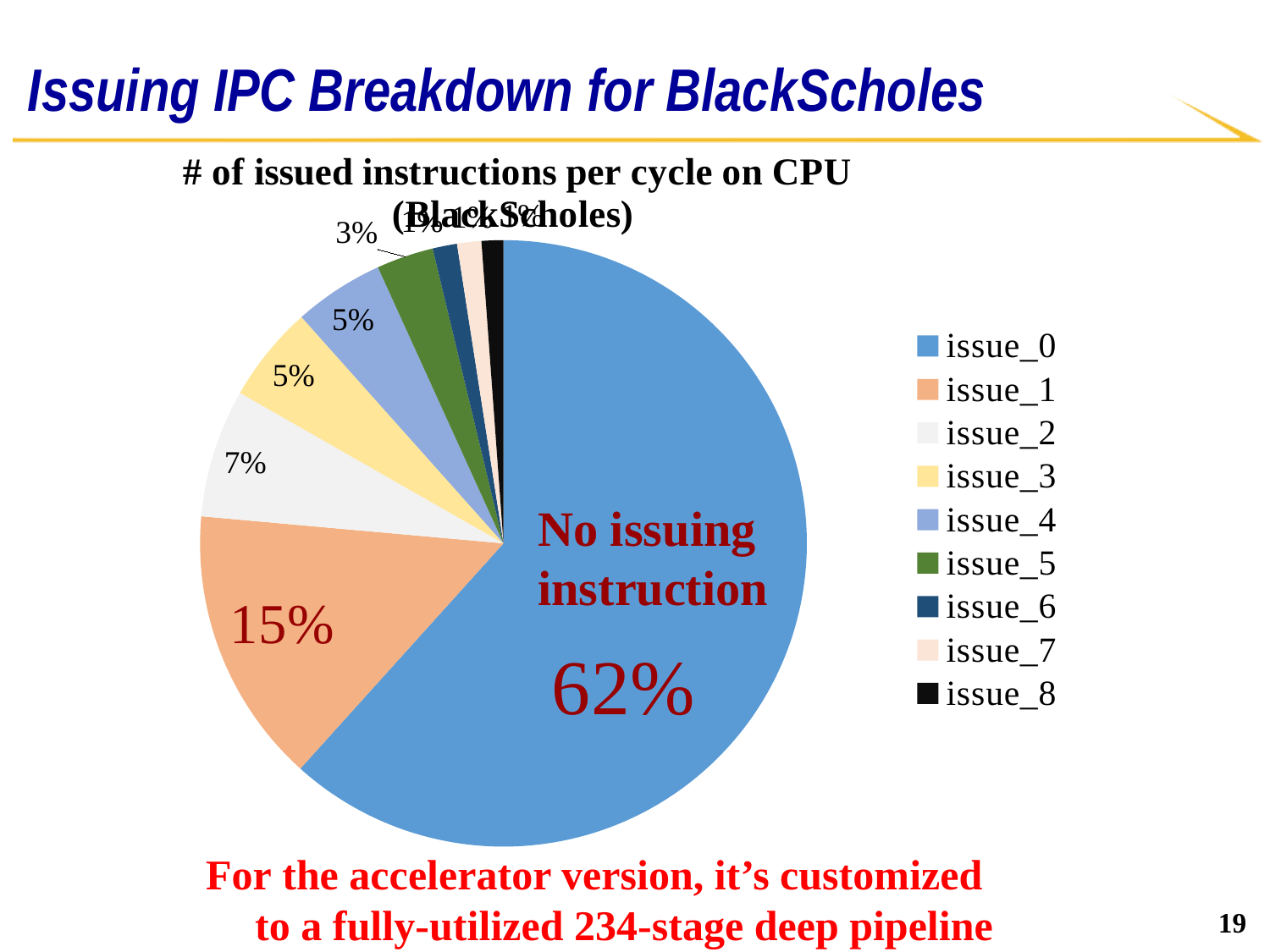
What kind of chart is shown on the slide? pie chart What is the value shown for issue_3? 5% Which is larger, the slice for issue_1 or the slice for issue_2? issue_1 What share of the pie does issue_0 take? 62% How many entries does the legend of the pie chart list? 9 What is the value shown for issue_1? 15% What label is written inside the largest slice of the pie? No issuing instruction What is the value shown for issue_2? 7% What colour is the issue_0 slice in the pie chart? blue Which category has the largest slice of the pie? issue_0 What is the value shown for issue_5? 3% What is the difference between the issue_0 and issue_1 slices? 47%